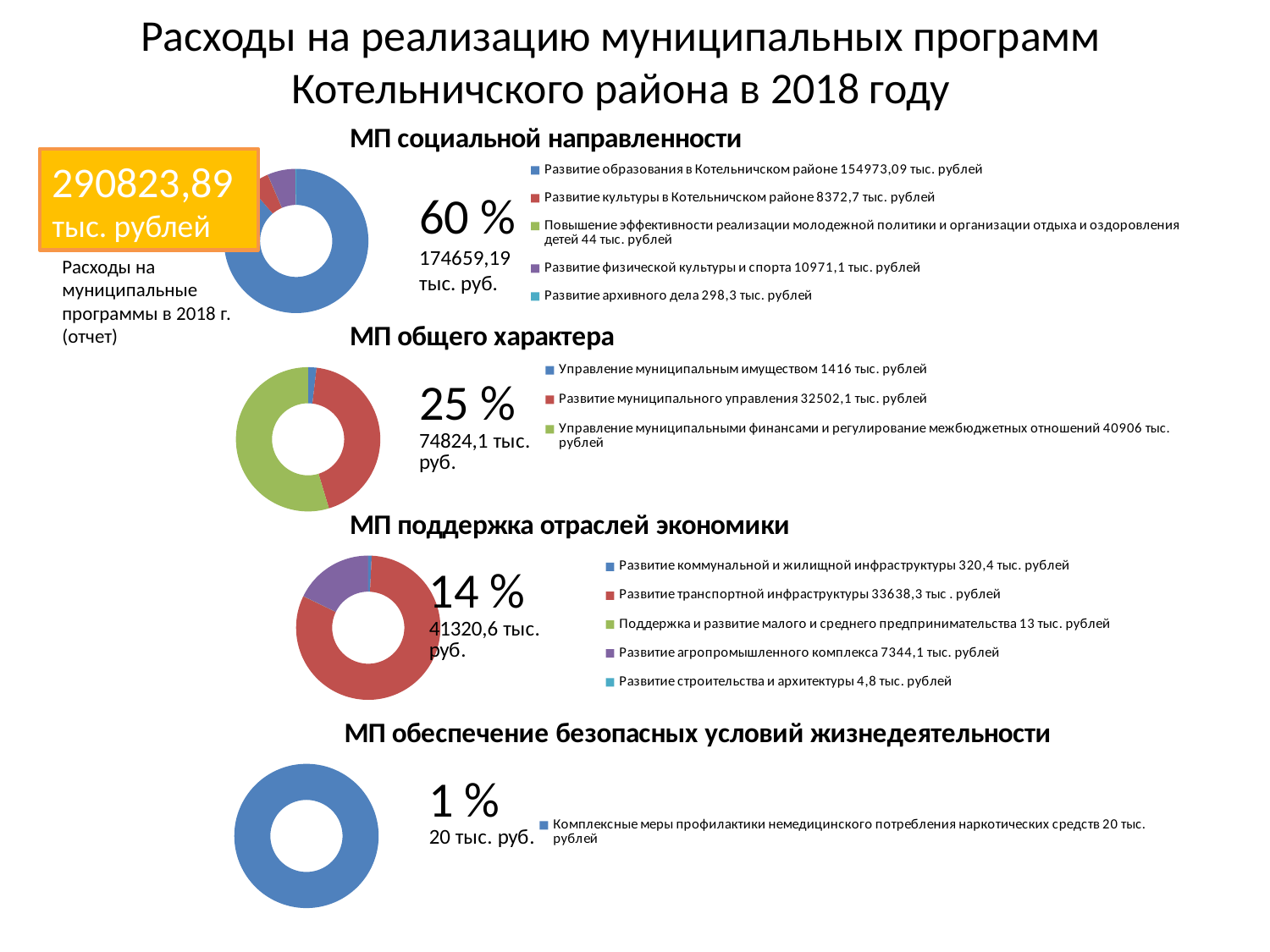
In the "МП поддержка отраслей экономики" chart, which is larger: "Развитие агропромышленного комплекса" or "Развитие коммунальной и жилищной инфраструктуры"? Развитие агропромышленного комплекса How many categories does the legend of the "МП обеспечение безопасных условий жизнедеятельности" chart list? 1 What share of total expenditure do the "МП социальной направленности" programmes account for, according to the slide? 60 % In the "МП общего характера" chart, which category has the largest value? Управление муниципальными финансами и регулирование межбюджетных отношений (40906 тыс. рублей) In the "МП социальной направленности" chart, which category has the smallest value? Повышение эффективности реализации молодежной политики и организации отдыха и оздоровления детей (44 тыс. рублей) What kind of chart is used for "МП социальной направленности"? Doughnut (pie) chart In the "МП поддержка отраслей экономики" chart, what is the value for "Развитие транспортной инфраструктуры"? 33638,3 тыс. рублей What is the total shown for the "МП общего характера" programmes? 74824,1 тыс. руб. In the "МП поддержка отраслей экономики" chart, which category has the smallest value? Развитие строительства и архитектуры (4,8 тыс. рублей) In the "МП общего характера" chart, what is the difference between "Управление муниципальными финансами и регулирование межбюджетных отношений" and "Развитие муниципального управления"? 8403,9 тыс. рублей In the "МП социальной направленности" chart, what is the value for "Развитие образования в Котельничском районе"? 154973,09 тыс. рублей In the "МП социальной направленности" chart, how many categories does the legend list? 5